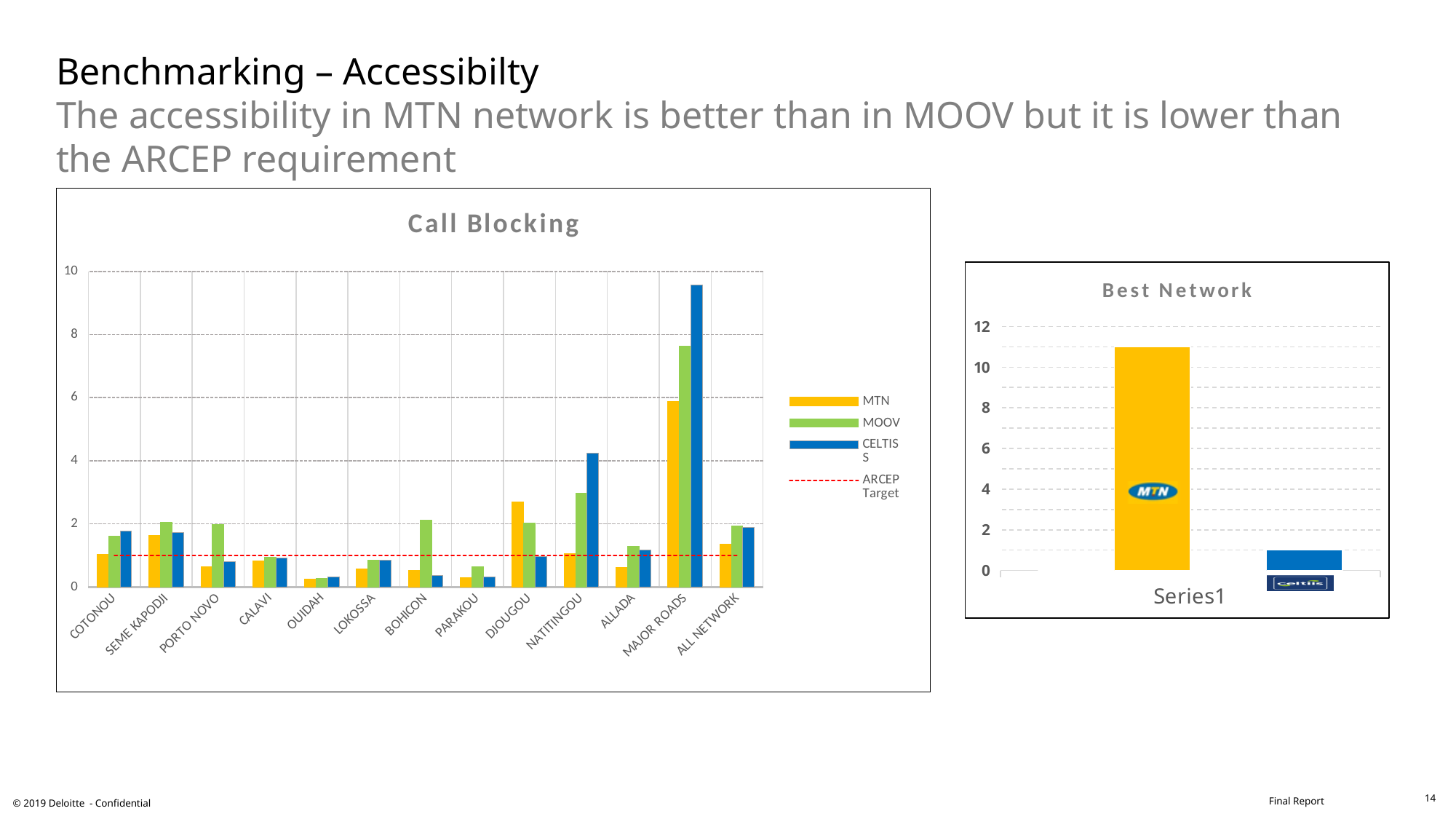
In the Call Blocking chart, which category has the highest CELTISS bar? MAJOR ROADS In the Best Network chart, is the MTN bar greater or less than 10? greater In the Call Blocking chart, which category has the highest MTN bar? MAJOR ROADS How many categories are shown on the x axis of the Call Blocking chart? 13 In the Call Blocking chart, is the MOOV value for MAJOR ROADS greater or less than 6? greater In the Call Blocking chart, which is larger at NATITINGOU, the MTN bar or the CELTISS bar? CELTISS In the Call Blocking chart, is the MTN value for DJOUGOU greater or less than 2? greater In the Call Blocking chart, how is the ARCEP Target shown? a red dashed line What kind of chart is the Call Blocking chart? bar chart How many entries does the legend of the Call Blocking chart list? 4 In the Call Blocking chart, which is larger at BOHICON, the MOOV bar or the CELTISS bar? MOOV